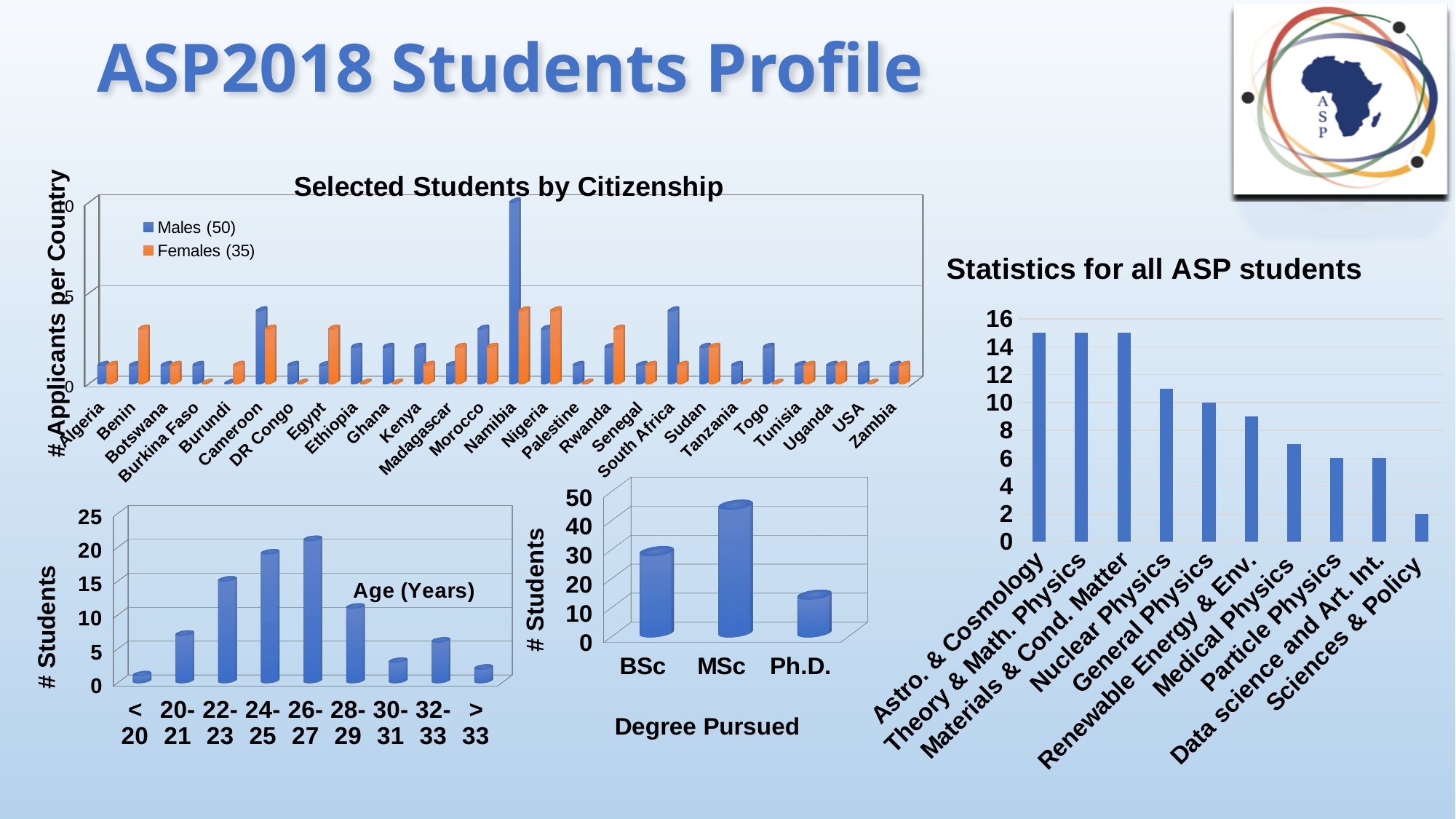
In the 'Degree Pursued' chart, which degree has the highest number of students? MSc In the 'Statistics for all ASP students' chart, do the values rise or fall from left to right along the x axis? fall In the 'Degree Pursued' chart, which is larger, the value for BSc or the value for Ph.D.? BSc In the 'Selected Students by Citizenship' chart, is the value for Namibia males greater or less than 5? greater How many countries are shown on the x axis of the 'Selected Students by Citizenship' chart? 26 What are the two legend entries in the 'Selected Students by Citizenship' chart? Males (50) and Females (35) In the age chart at the bottom left, is the value for the 24-25 age group greater or less than 15? greater How many age groups are shown in the age chart at the bottom left? 9 In the 'Statistics for all ASP students' chart, which category has the lowest value? Sciences & Policy In the age chart at the bottom left, which age group has the highest number of students? 26-27 In the 'Selected Students by Citizenship' chart, which country has the highest number of male applicants? Namibia How many series does the legend of the 'Selected Students by Citizenship' chart list? 2